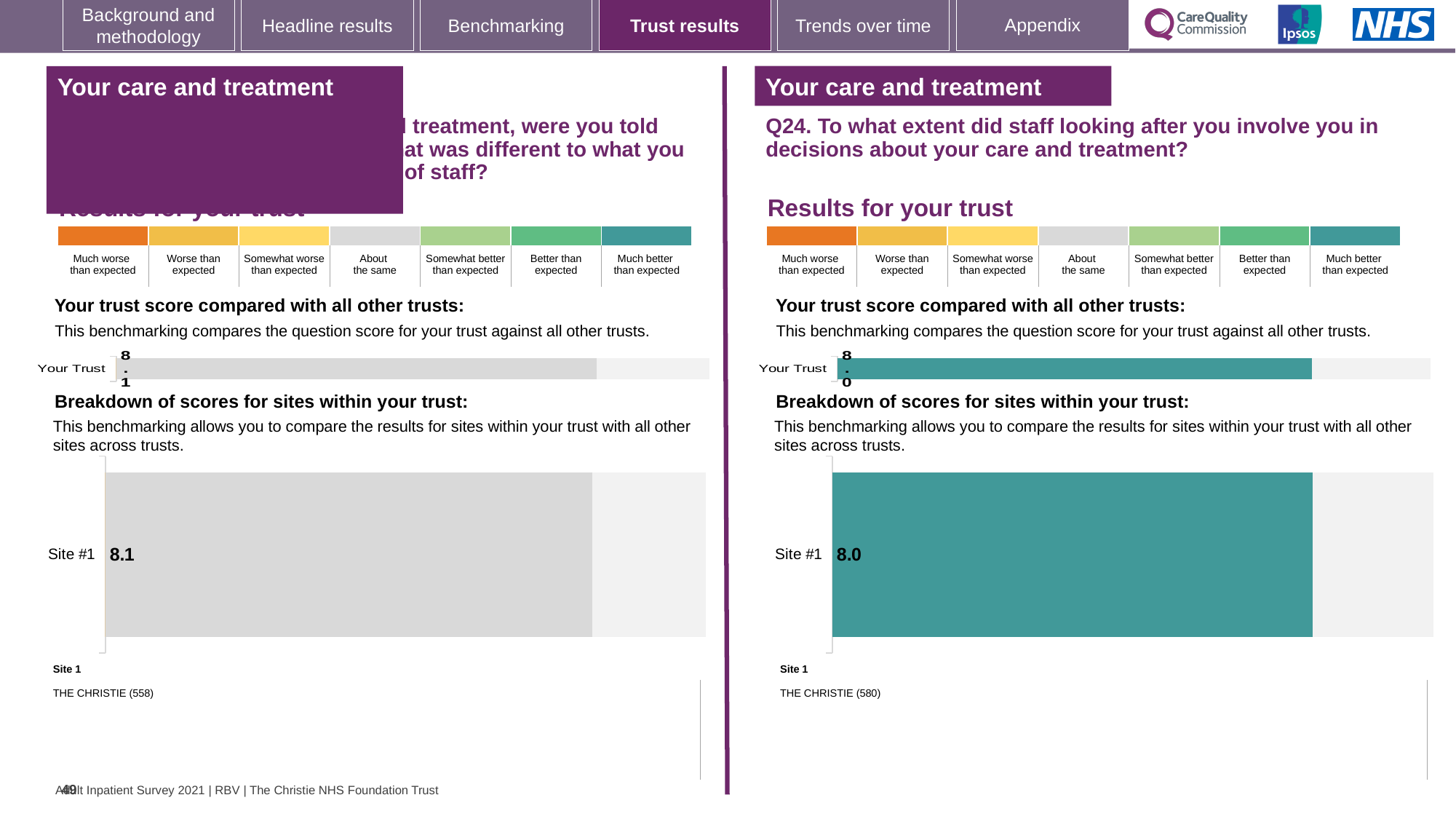
What kind of chart is used to show the Site #1 score for Q24? bar chart In the left-hand chart, what score is shown for Site #1? 8.1 In the left-hand chart, what is the score shown for Your Trust? 8.1 In the right-hand chart for Q24, which benchmark category does the colour of the Site #1 bar correspond to? Much better than expected What is the difference between the Site #1 score in the left-hand chart and the Site #1 score in the right-hand chart for Q24? 0.1 In the right-hand chart for Q24, what is the score shown for Your Trust? 8.0 How many sites are shown in the breakdown chart for Q24 on the right-hand side? 1 In the left-hand chart, which benchmark category does the colour of the Site #1 bar correspond to? About the same In the right-hand chart for Q24, what score is shown for Site #1? 8.0 Which chart shows the higher Site #1 score, the left-hand chart or the right-hand chart for Q24? the left-hand chart How many sites are shown in the breakdown chart on the left-hand side? 1